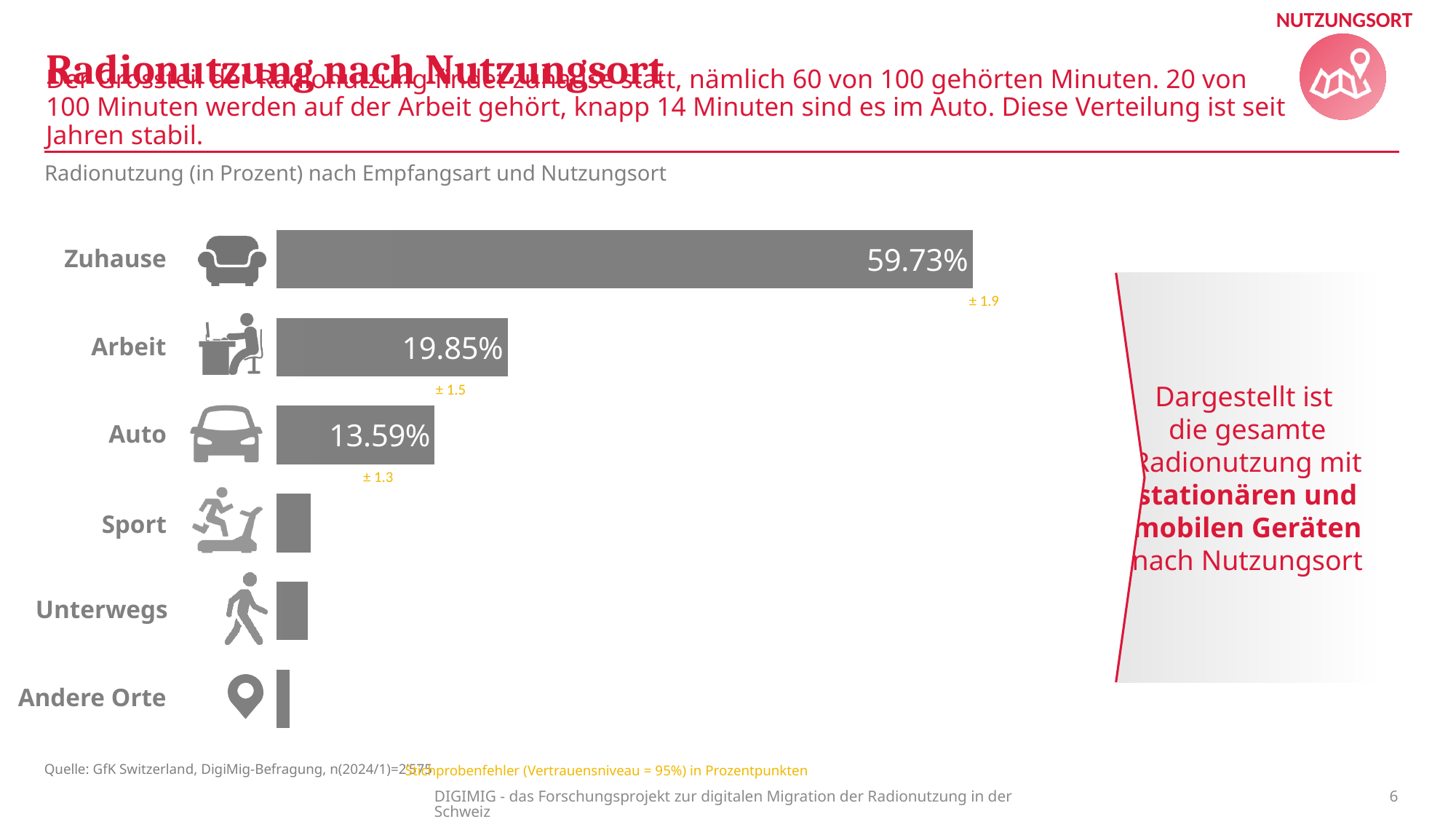
What is the value for Zuhause? 59.73% Which category has the highest value? Zuhause Which is larger, the value for Sport or the value for Zuhause? Zuhause What is the sampling error (Stichprobenfehler) shown for Zuhause? ± 1.9 What is the value for Auto? 13.59% What kind of chart is shown on the slide? Bar chart Which category has the lowest value? Andere Orte What is the difference between the values for Arbeit and Auto? 6.26 percentage points Which is larger, the value for Arbeit or the value for Auto? Arbeit How many categories are shown in the chart? 6 What is the difference between the values for Zuhause and Arbeit? 39.88 percentage points What is the value for Arbeit? 19.85%